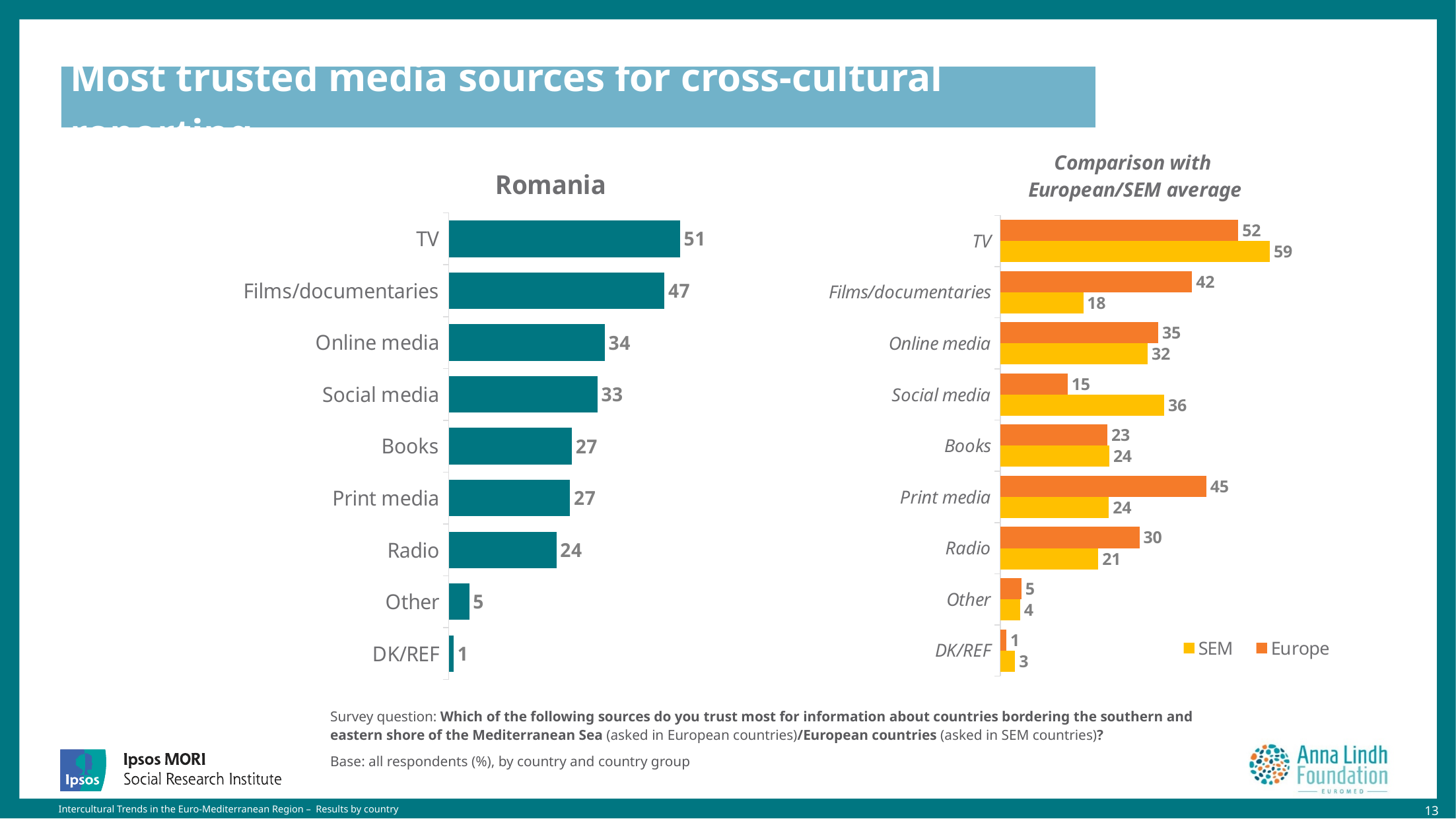
In the Comparison with European/SEM average chart, what is the SEM value for TV? 59 In the Comparison with European/SEM average chart, which is larger for Social media, the Europe value or the SEM value? SEM In the Comparison with European/SEM average chart, what is the Europe value for Print media? 45 In the Romania chart, which category has the lowest value? DK/REF In the Romania chart, what is the difference between TV and Films/documentaries? 4 In the Romania chart, what is the value for Social media? 33 What type of chart is the Romania chart? Bar chart How many series does the legend of the Comparison with European/SEM average chart list? 2 In the Romania chart, which category has the highest value? TV In the Romania chart, how many categories are shown? 9 In the Romania chart, what is the value for TV? 51 In the Comparison with European/SEM average chart, what is the difference between the Europe and SEM values for Films/documentaries? 24